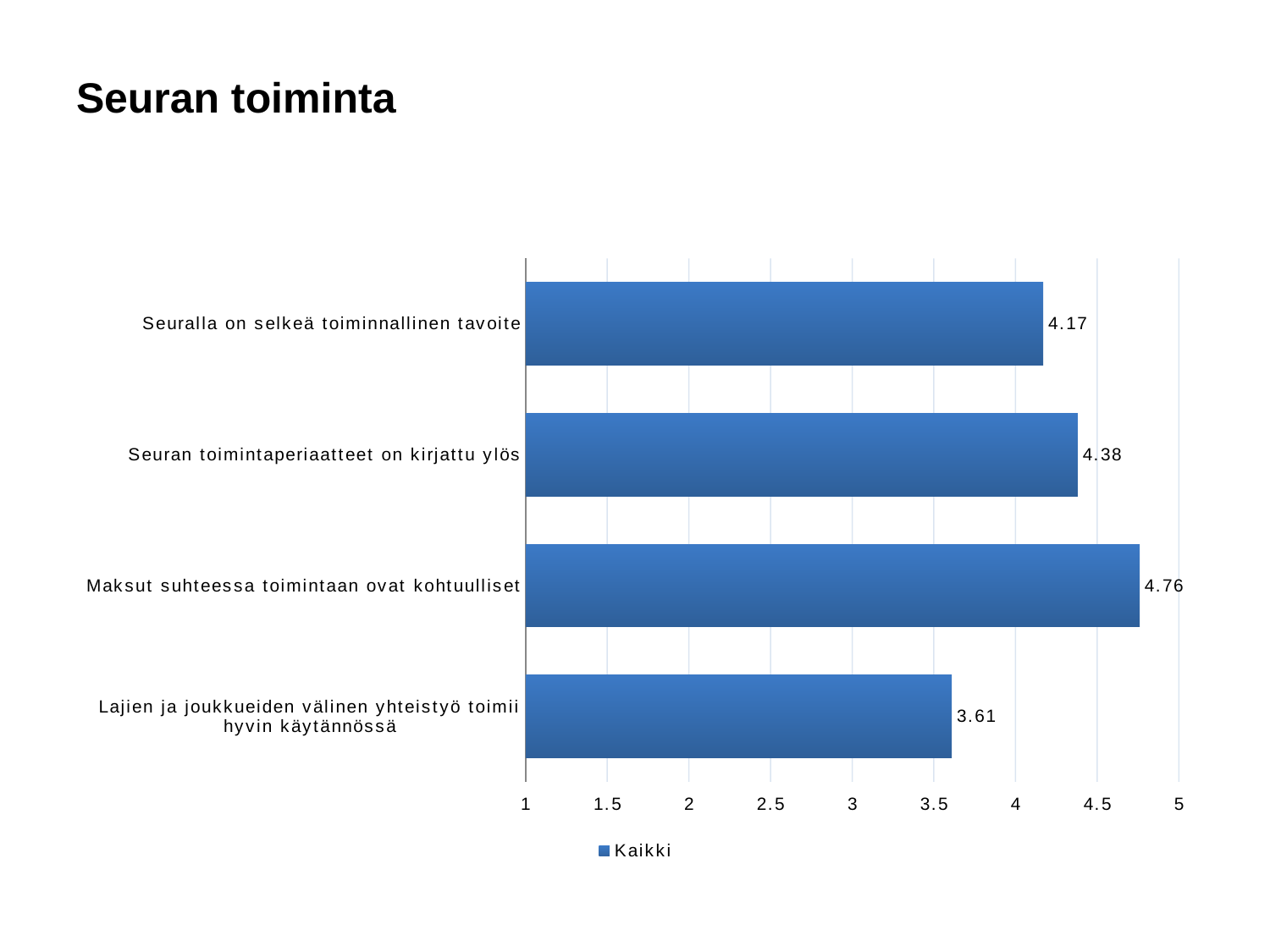
What is the difference between the values for "Seuran toimintaperiaatteet on kirjattu ylös" and "Seuralla on selkeä toiminnallinen tavoite"? 0.21 What is the value for "Seuralla on selkeä toiminnallinen tavoite"? 4.17 What is the value for "Maksut suhteessa toimintaan ovat kohtuulliset"? 4.76 What is the difference between the values for "Maksut suhteessa toimintaan ovat kohtuulliset" and "Lajien ja joukkueiden välinen yhteistyö toimii hyvin käytännössä"? 1.15 What is the value for "Seuran toimintaperiaatteet on kirjattu ylös"? 4.38 What is the value for "Lajien ja joukkueiden välinen yhteistyö toimii hyvin käytännössä"? 3.61 What kind of chart is shown on the slide? Bar chart How many categories are shown in the chart? 4 Which category has the highest value? Maksut suhteessa toimintaan ovat kohtuulliset Which category has the lowest value? Lajien ja joukkueiden välinen yhteistyö toimii hyvin käytännössä How many series does the legend list? 1 Which is larger: the value for "Seuran toimintaperiaatteet on kirjattu ylös" or the value for "Seuralla on selkeä toiminnallinen tavoite"? Seuran toimintaperiaatteet on kirjattu ylös